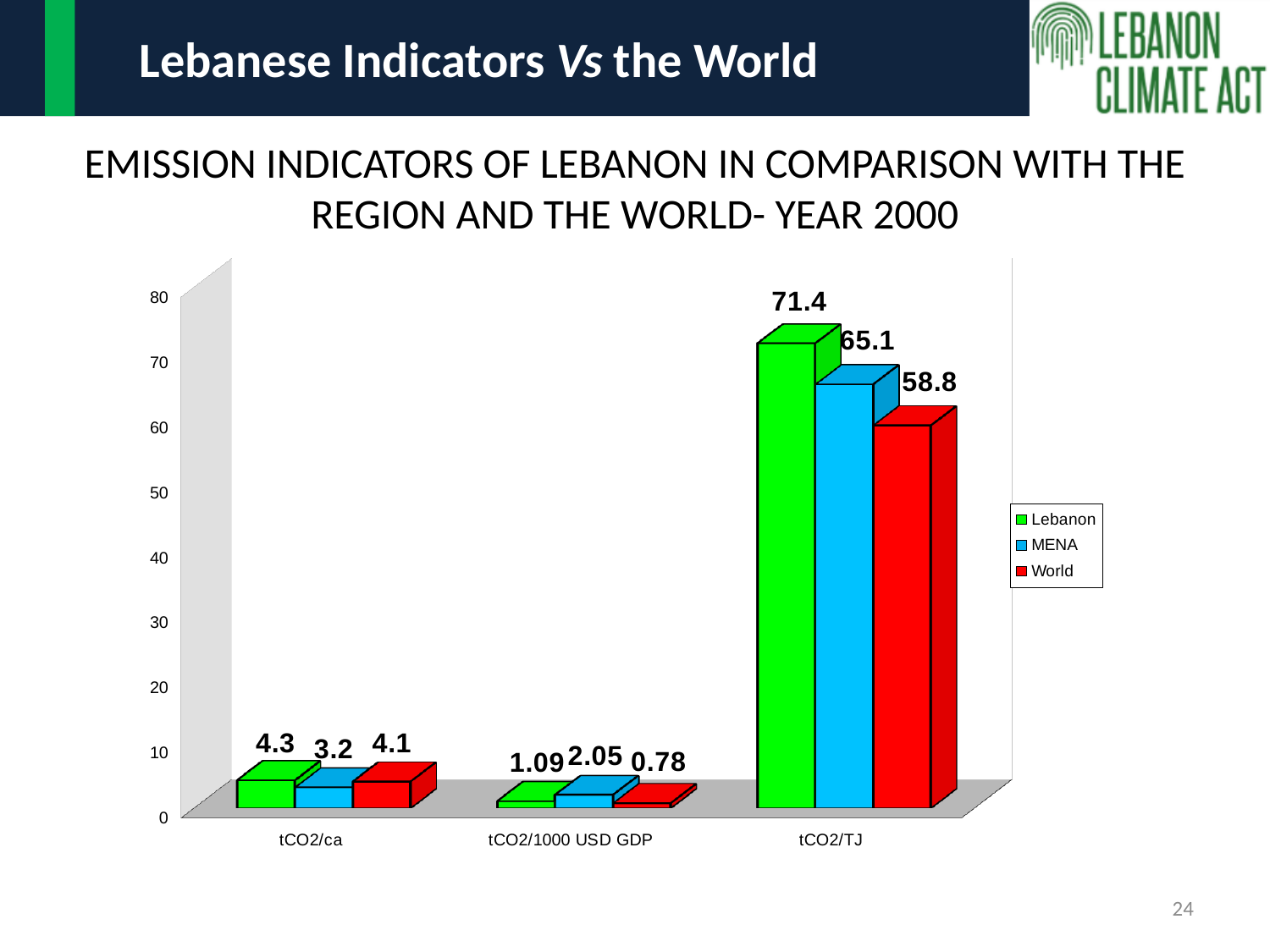
Which is larger in the tCO2/ca category, the value for Lebanon or the value for MENA? Lebanon What is the difference between the Lebanon and World values in the tCO2/TJ category? 12.6 What is the value for MENA in the tCO2/1000 USD GDP category? 2.05 How many series does the legend list? 3 What is the value for MENA in the tCO2/TJ category? 65.1 How many categories are shown on the x axis? 3 Which colour represents the World series in the legend? Red What kind of chart is shown on the slide? Bar chart What is the value for Lebanon in the tCO2/TJ category? 71.4 Which series has the lowest value in the tCO2/1000 USD GDP category? World Which series has the highest value in the tCO2/TJ category? Lebanon What is the value for World in the tCO2/ca category? 4.1